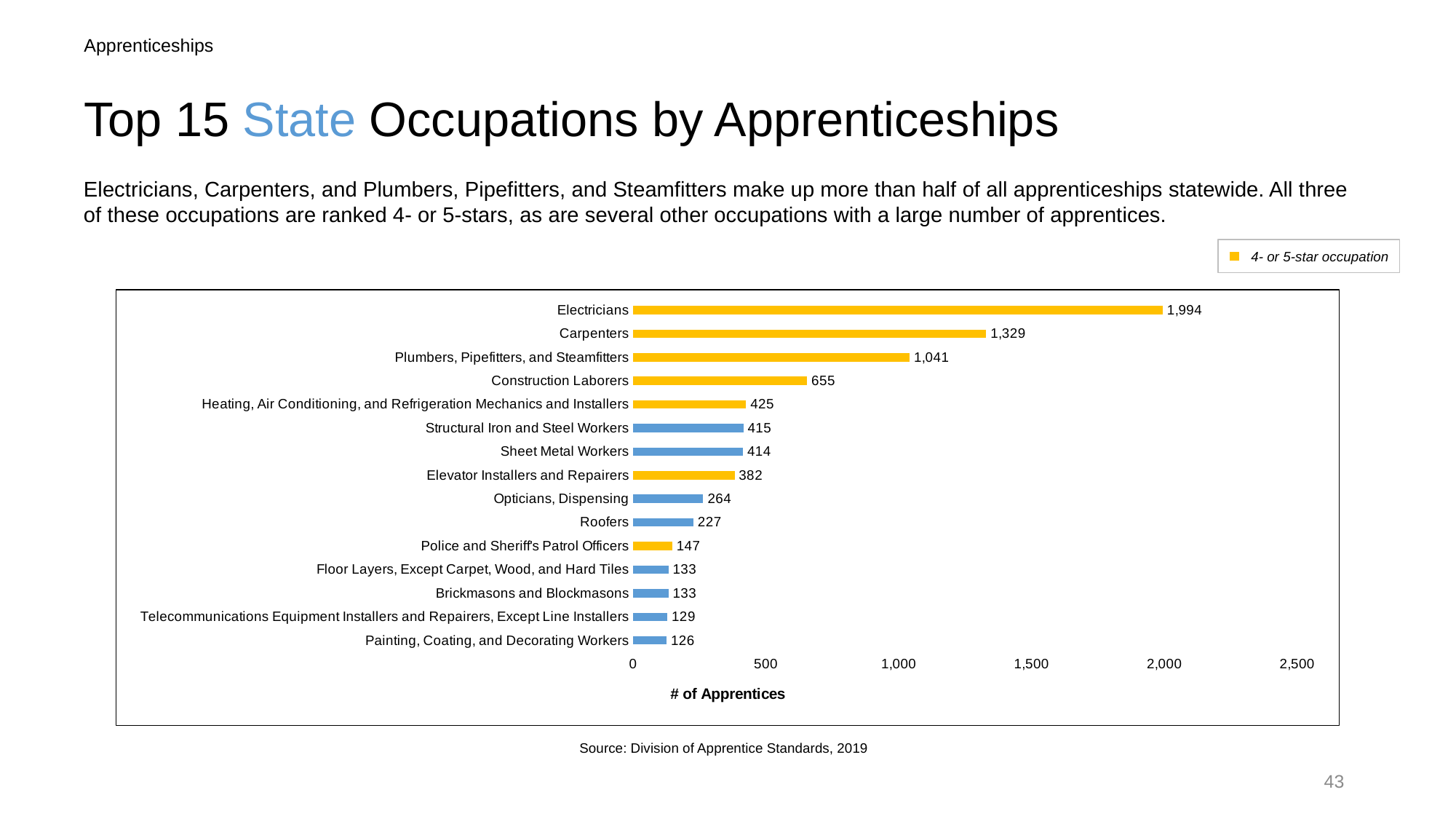
What kind of chart is shown on the slide? bar chart Which occupation has the highest number of apprentices? Electricians Which occupation has the lowest number of apprentices? Painting, Coating, and Decorating Workers How many occupations are shown in the chart? 15 Which has more apprentices, Sheet Metal Workers or Opticians, Dispensing? Sheet Metal Workers What does the yellow bar colour indicate according to the legend? 4- or 5-star occupation What is the difference in apprentices between Electricians and Carpenters? 665 What is the number of apprentices for Construction Laborers? 655 How many apprentices are shown for Electricians? 1,994 Is the value for Plumbers, Pipefitters, and Steamfitters greater or less than 1,000? greater What is the label of the horizontal axis? # of Apprentices How many apprentices are shown for Roofers? 227